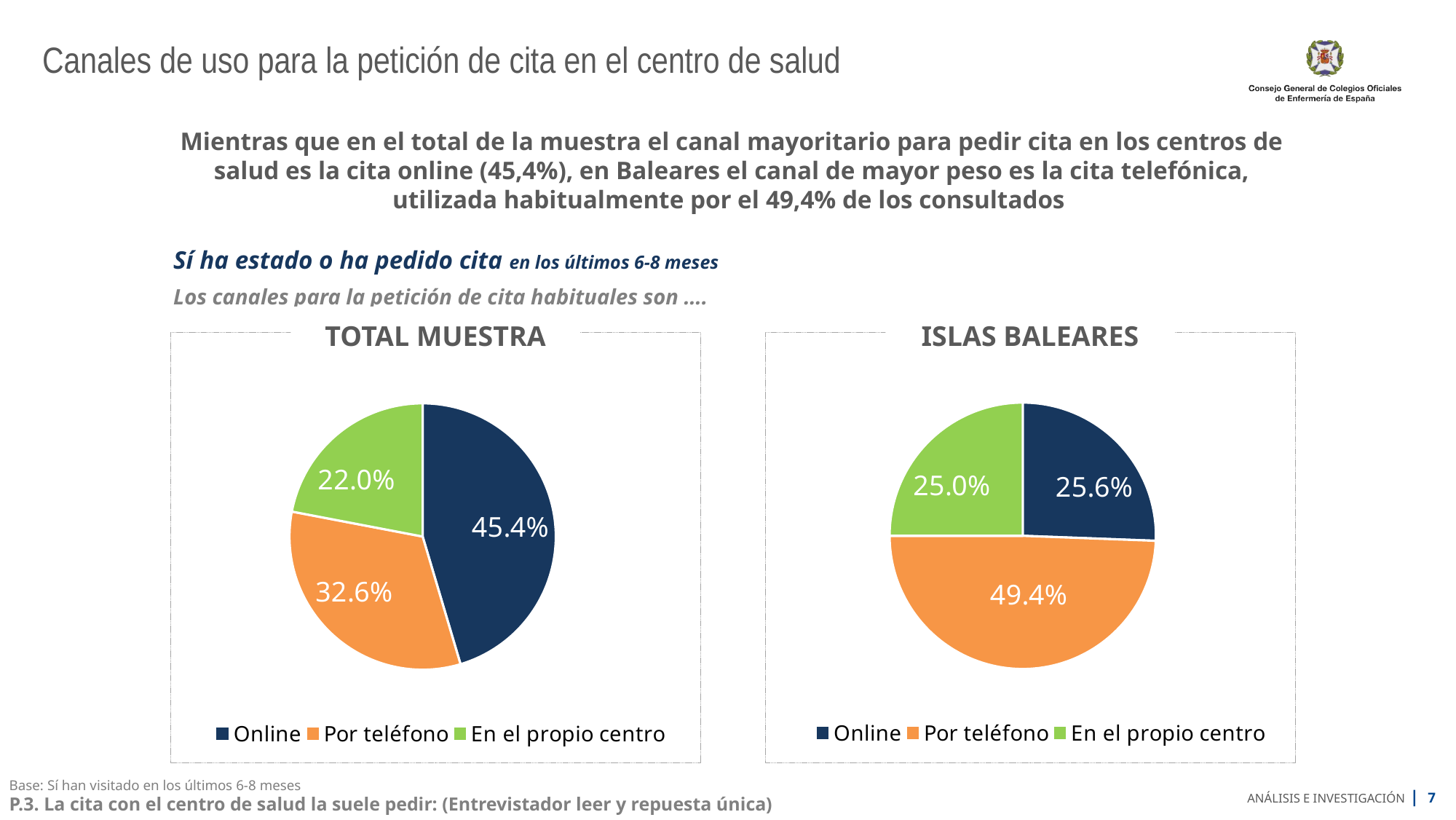
How many categories does the legend of the TOTAL MUESTRA chart list? 3 In the ISLAS BALEARES chart, which category has the largest share? Por teléfono In the ISLAS BALEARES chart, what is the value for Por teléfono? 49.4% In the TOTAL MUESTRA chart, what is the difference between Online and Por teléfono? 12.8% In the TOTAL MUESTRA chart, what is the value for Por teléfono? 32.6% In the TOTAL MUESTRA chart, which category has the largest share? Online In the TOTAL MUESTRA chart, which category has the smallest share? En el propio centro In the ISLAS BALEARES chart, what is the value for En el propio centro? 25.0% In the ISLAS BALEARES chart, what is the difference between Por teléfono and Online? 23.8% What type of chart is the ISLAS BALEARES chart? Pie chart In the TOTAL MUESTRA chart, what is the value for Online? 45.4% Which is larger: Online in the TOTAL MUESTRA chart or Online in the ISLAS BALEARES chart? TOTAL MUESTRA